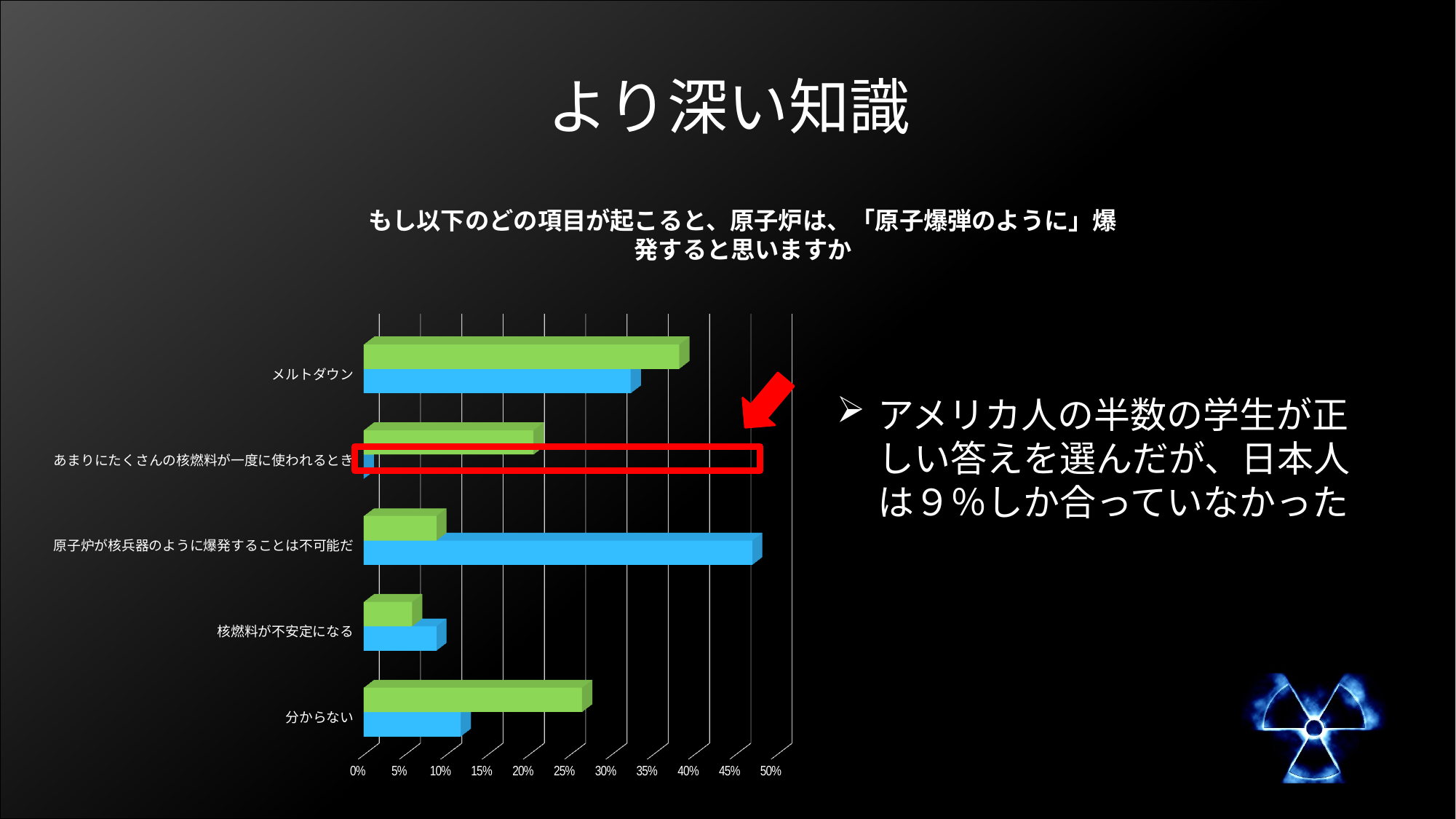
Which category has the shortest blue bar? あまりにたくさんの核燃料が一度に使われるとき What kind of chart is shown on the slide? Bar chart What is the title of the chart? もし以下のどの項目が起こると、原子炉は、「原子爆弾のように」爆発すると思いますか How many categories are shown on the chart's vertical axis? 5 Is the blue bar for 原子炉が核兵器のように爆発することは不可能だ greater or less than 40%? greater Which category has the longest blue bar? 原子炉が核兵器のように爆発することは不可能だ Is the green bar for メルトダウン greater or less than 35%? greater For 原子炉が核兵器のように爆発することは不可能だ, which bar is longer, the green one or the blue one? The blue one Is the blue bar for 分からない greater or less than 15%? less Which category has the longest green bar? メルトダウン For メルトダウン, which bar is longer, the green one or the blue one? The green one